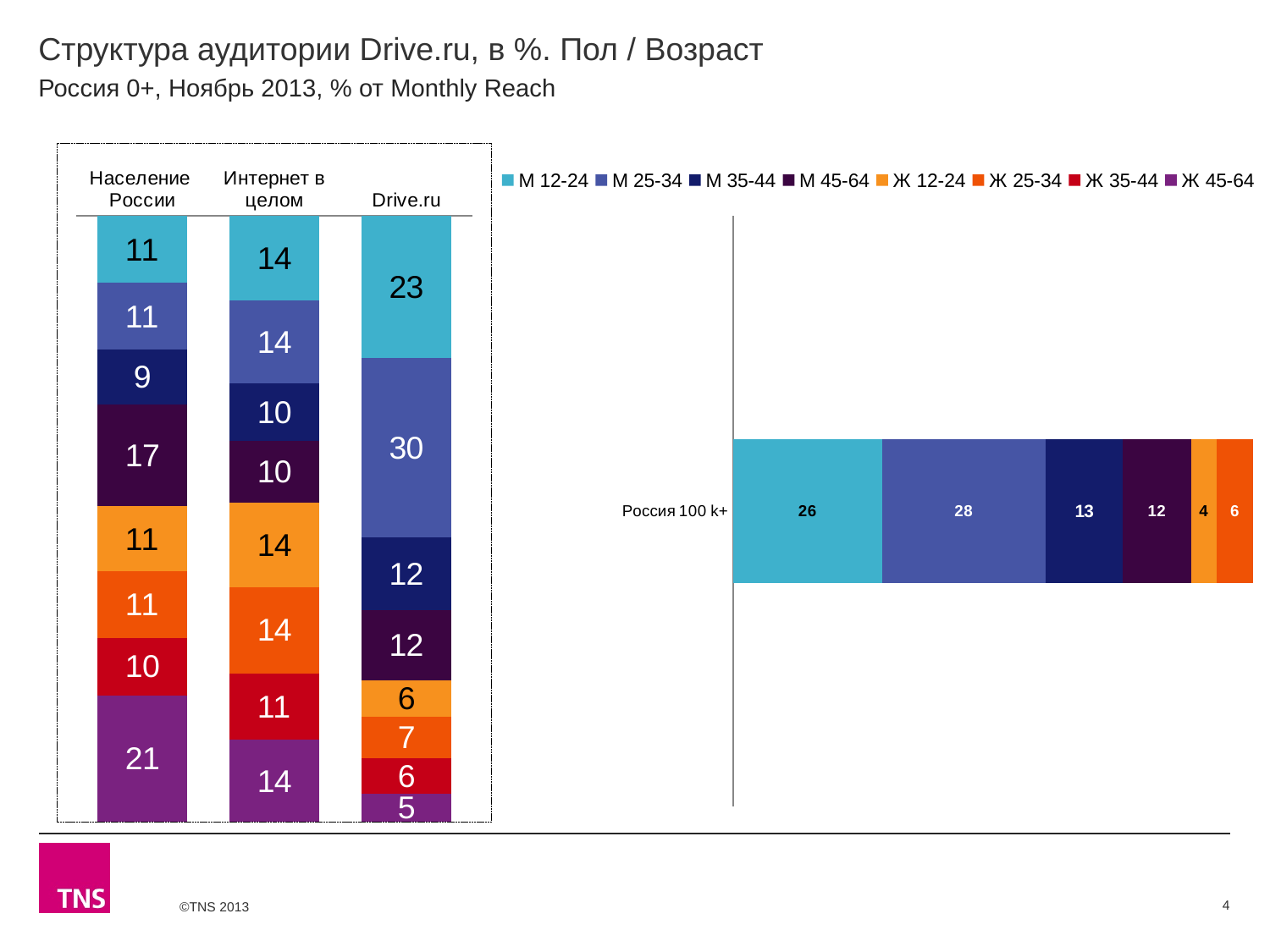
What type of chart is the Россия 100 k+ chart on the right? Bar chart How many bars does the left stacked bar chart contain? 3 In the left stacked bar chart, which segment is the smallest in the Drive.ru bar? Ж 45-64 In the Россия 100 k+ chart on the right, what is the value of the М 25-34 segment? 28 In the left stacked bar chart, what is the value of the М 35-44 segment in the Интернет в целом bar? 10 In the left stacked bar chart, what is the value of the М 25-34 segment in the Drive.ru bar? 30 In the left stacked bar chart, what is the value of the Ж 45-64 segment in the Население России bar? 21 In the left stacked bar chart, what is the difference between the М 12-24 value for Drive.ru and the М 12-24 value for Население России? 12 In the left stacked bar chart, which is larger: the М 45-64 value for Drive.ru or for Население России? Население России In the left stacked bar chart, which segment is the largest in the Drive.ru bar? М 25-34 How many series does the legend list? 8 In the Россия 100 k+ chart on the right, what is the difference between the М 12-24 and М 35-44 segments? 13